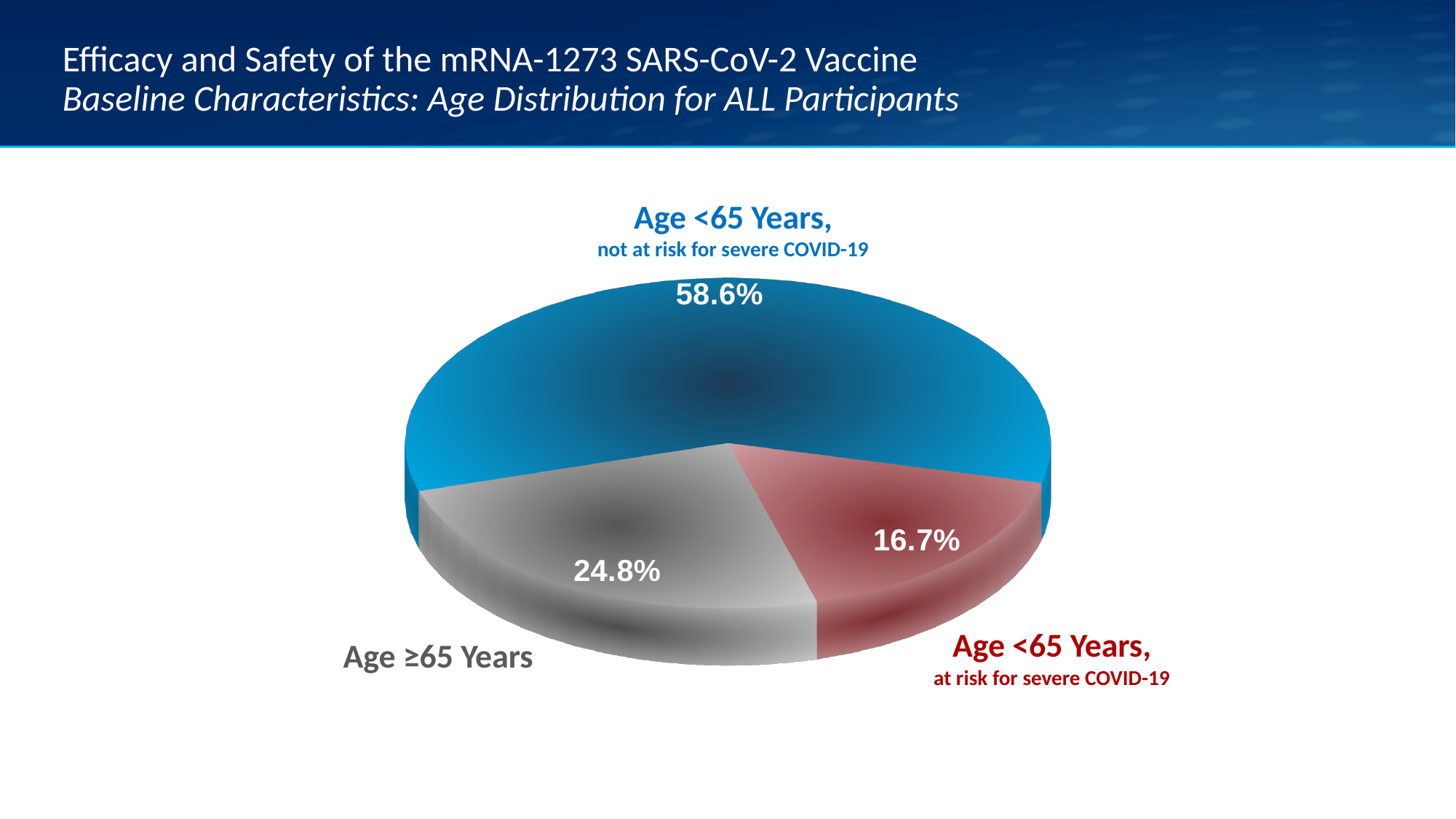
Which category has the largest share of the pie? Age <65 Years, not at risk for severe COVID-19 What is the difference in percentage points between the Age ≥65 Years slice and the Age <65 Years, at risk for severe COVID-19 slice? 8.1 What colour is the slice for Age ≥65 Years? Grey How many slices does the pie chart have? 3 Which is larger: the share for Age ≥65 Years or the share for Age <65 Years, at risk for severe COVID-19? Age ≥65 Years What is the difference in percentage points between the Age <65 Years, not at risk slice and the Age ≥65 Years slice? 33.8 What percentage of participants are Age ≥65 Years? 24.8% What colour is the slice for Age <65 Years, at risk for severe COVID-19? Red What kind of chart is shown on the slide? Pie chart What percentage of participants are Age <65 Years, not at risk for severe COVID-19? 58.6% What percentage of participants are Age <65 Years, at risk for severe COVID-19? 16.7% Which category has the smallest share of the pie? Age <65 Years, at risk for severe COVID-19